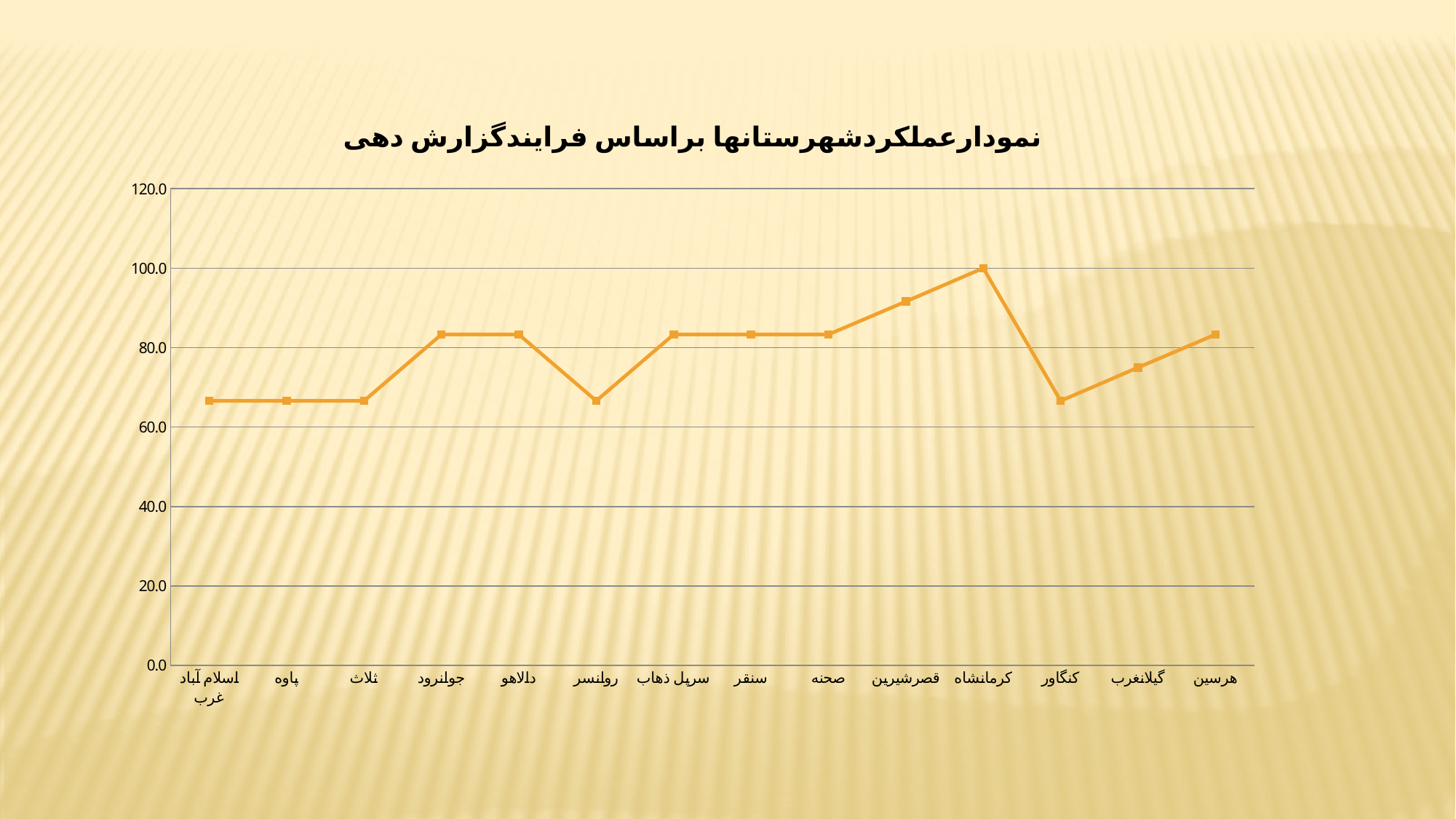
Is the value for قصرشیرین greater or less than 100? less Is the value for جوانرود greater or less than 80? greater Is the value for کنگاور greater or less than 60? greater What is the value for کرمانشاه? 100.0 Which has the larger value, کرمانشاه or کنگاور? کرمانشاه What kind of chart is shown on the slide? line chart What is the title of the chart? نمودارعملکردشهرستانها براساس فرایندگزارش دهی How many categories (cities) are plotted along the x axis? 14 Which category has the highest value? کرمانشاه Do the values rise or fall from کنگاور to هرسین? rise Which has the larger value, قصرشیرین or صحنه? قصرشیرین